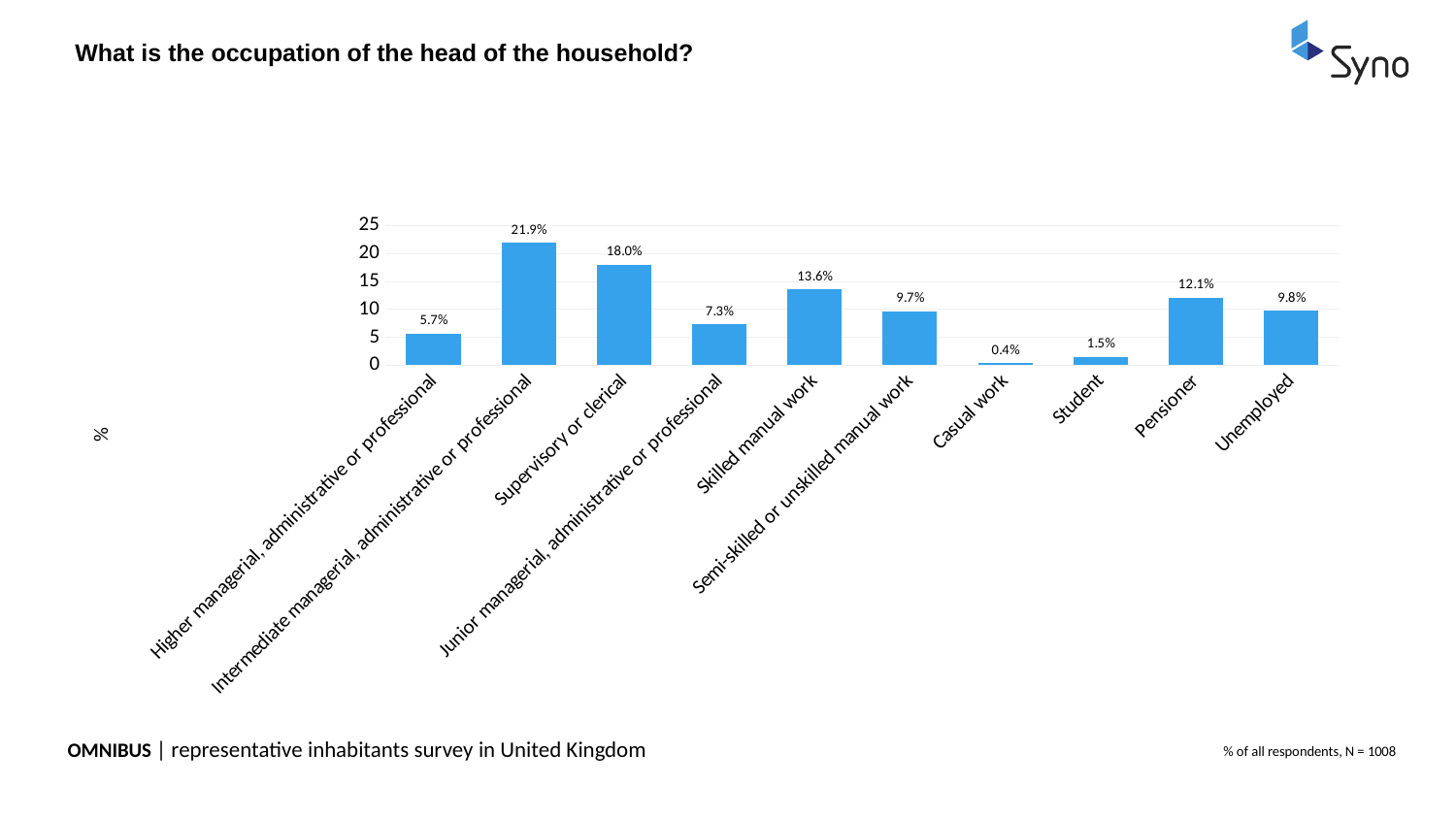
How many categories are shown in the chart? 10 What is the title of the slide? What is the occupation of the head of the household? Is the value for Higher managerial, administrative or professional greater or less than 10? less What is the value for Intermediate managerial, administrative or professional? 21.9% What is the value for Student? 1.5% What is the difference between Supervisory or clerical and Skilled manual work? 4.4% What kind of chart is shown on the slide? bar chart What is the value for Pensioner? 12.1% What is the value for Casual work? 0.4% Which category has the highest value? Intermediate managerial, administrative or professional Which category has the lowest value? Casual work Which is larger, Unemployed or Semi-skilled or unskilled manual work? Unemployed